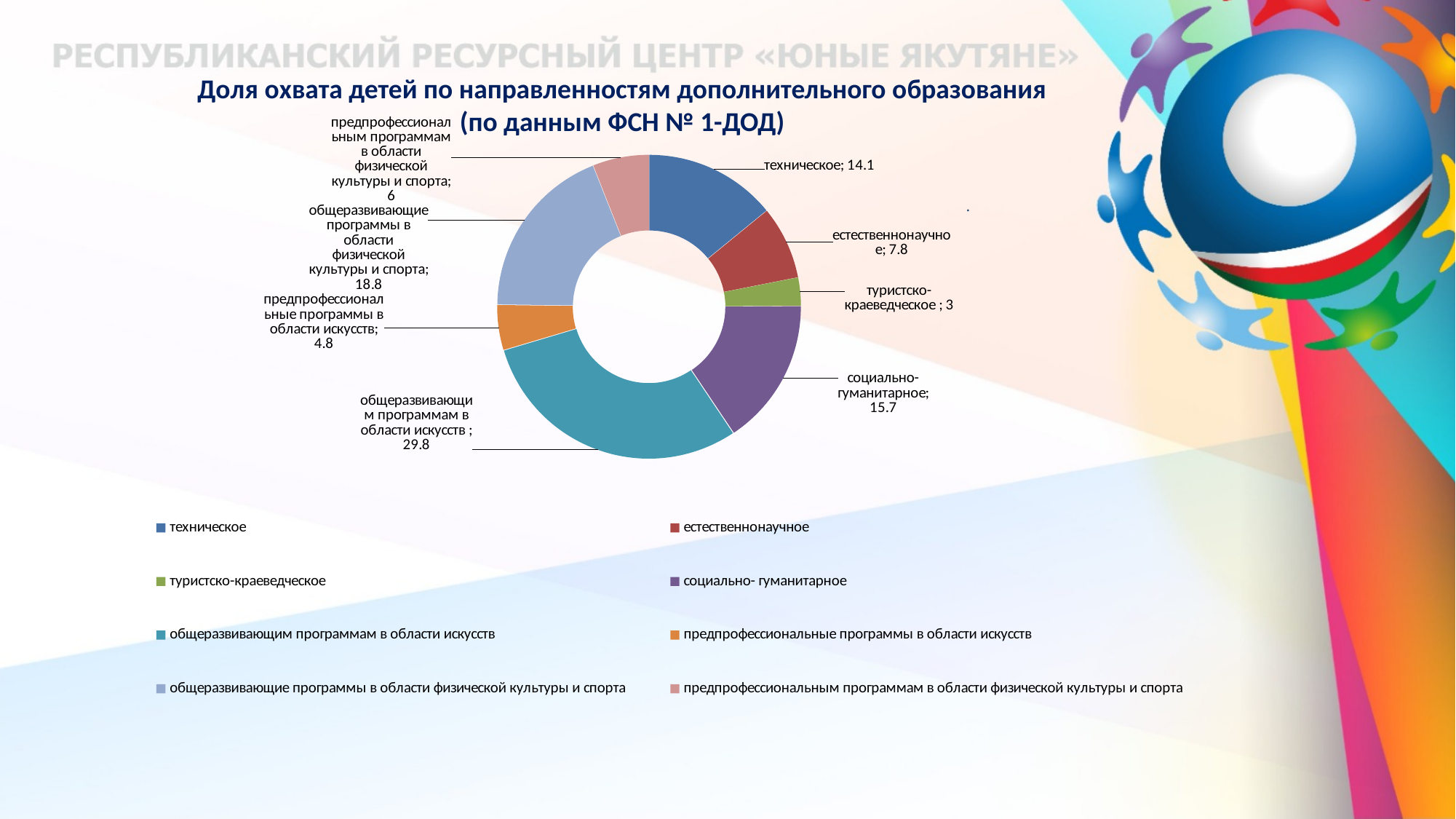
What is the difference between the values for социально-гуманитарное and техническое? 1.6 What is the title of the chart? Доля охвата детей по направленностям дополнительного образования (по данным ФСН № 1-ДОД) What is the difference between the values for общеразвивающим программам в области искусств and общеразвивающие программы в области физической культуры и спорта? 11 What type of chart is shown on the slide? Doughnut (pie) chart Which category has the smallest share of the chart? туристско-краеведческое What is the value for социально-гуманитарное? 15.7 Which is larger: естественнонаучное or предпрофессиональные программы в области искусств? естественнонаучное What is the value for общеразвивающие программы в области физической культуры и спорта? 18.8 What is the value for туристско-краеведческое? 3 What is the value for техническое? 14.1 How many categories does the chart show? 8 Which category has the largest share of the chart? общеразвивающим программам в области искусств